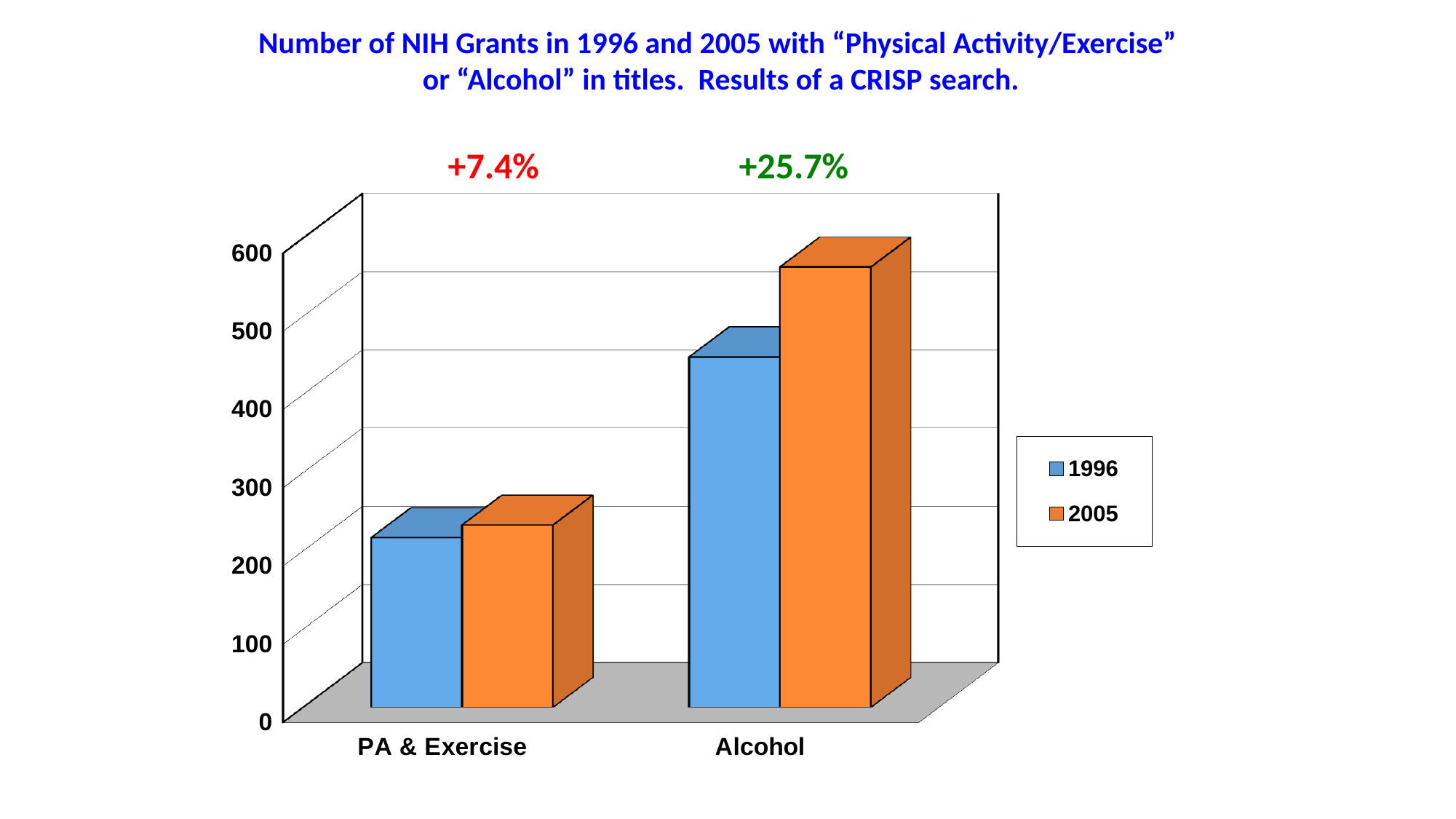
Is the value for Alcohol in 1996 greater or less than 400? greater For Alcohol, which year has the larger number of grants, 1996 or 2005? 2005 Which series are listed in the legend? 1996 and 2005 How many categories are shown on the x axis? 2 How many series does the legend list? 2 What percentage change is printed above the Alcohol bars? +25.7% Is the value for Alcohol in 2005 greater or less than 500? greater Which category and year has the tallest bar? Alcohol, 2005 What kind of chart is shown on the slide? bar chart Which category and year has the shortest bar? PA & Exercise, 1996 Is the value for PA & Exercise in 1996 greater or less than 300? less What percentage change is printed above the PA & Exercise bars? +7.4%